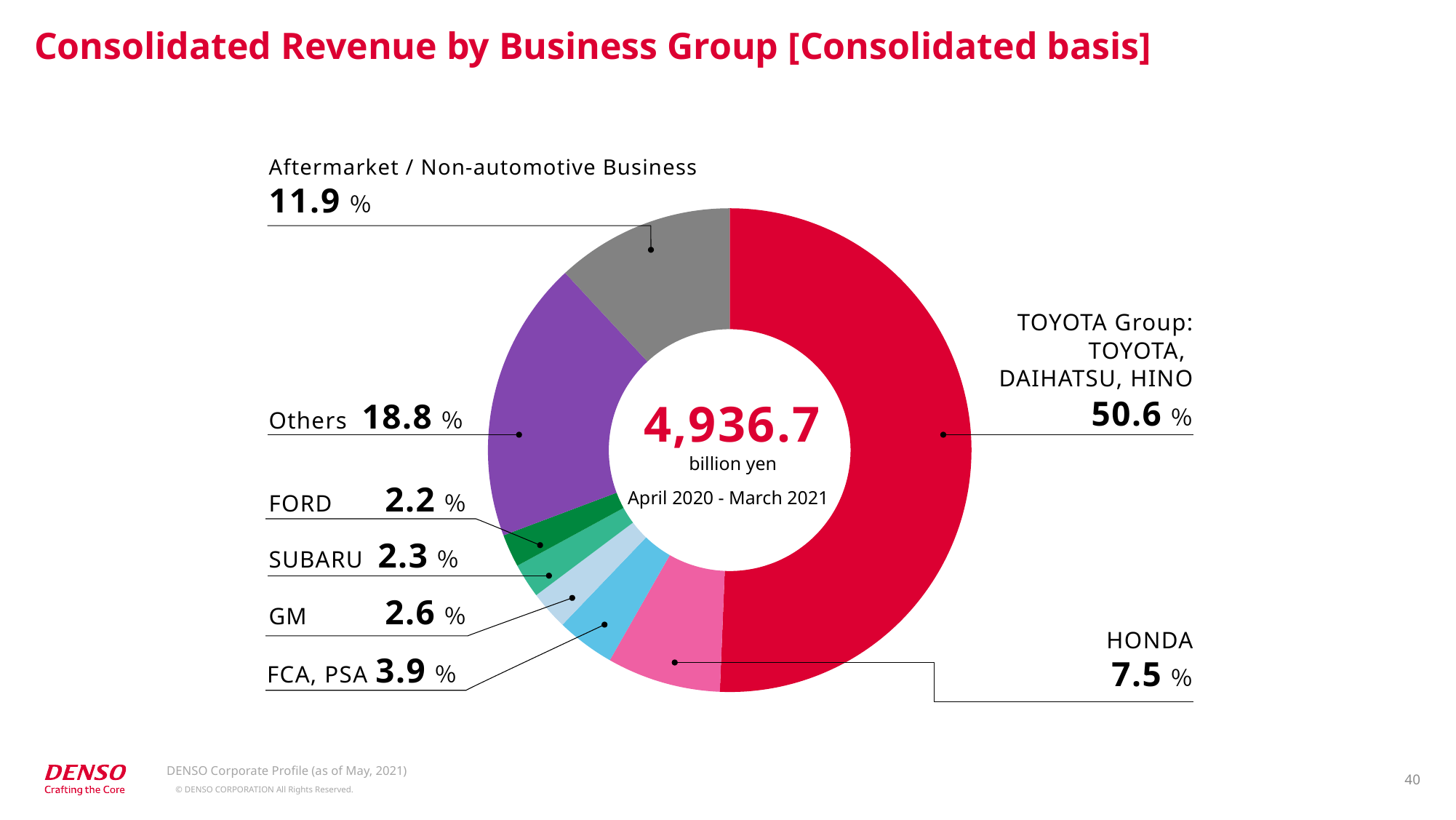
What share of consolidated revenue comes from the TOYOTA Group? 50.6% What is the difference in percentage points between the Others share and the HONDA share? 11.3 What share of consolidated revenue comes from the Aftermarket / Non-automotive Business? 11.9% What total consolidated revenue is shown in the centre of the chart? 4,936.7 billion yen What period does the chart cover? April 2020 - March 2021 What share of consolidated revenue comes from FCA, PSA? 3.9% Which business group has the largest share of consolidated revenue? TOYOTA Group What kind of chart is shown on the slide? Pie chart (donut) Which has a larger share of consolidated revenue, GM or SUBARU? GM What share of consolidated revenue comes from HONDA? 7.5% How many segments does the chart show? 8 Which business group has the smallest share of consolidated revenue? FORD